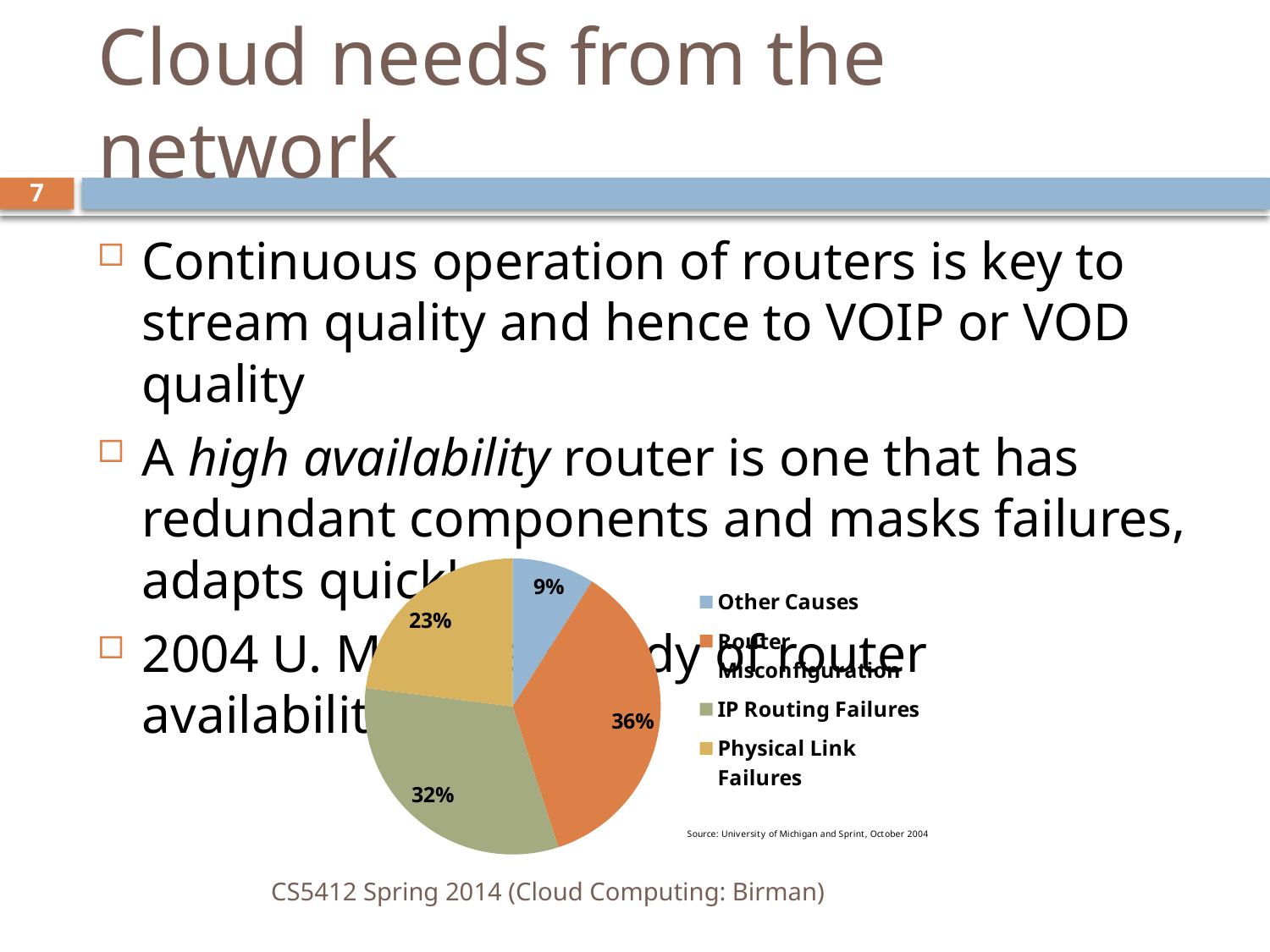
Which category has the smallest slice of the pie? Other Causes How many slices does the pie chart have? 4 What share of the pie is Physical Link Failures? 23% According to the note below the chart, what is the source of the data? University of Michigan and Sprint, October 2004 Which is larger, Physical Link Failures or Other Causes? Physical Link Failures Which category has the largest slice of the pie? Router Misconfiguration What kind of chart is shown on the slide? pie chart What share of the pie is Other Causes? 9% What is the difference in percentage points between Physical Link Failures and Other Causes? 14 What is the difference in percentage points between Router Misconfiguration and IP Routing Failures? 4 What share of the pie is IP Routing Failures? 32%